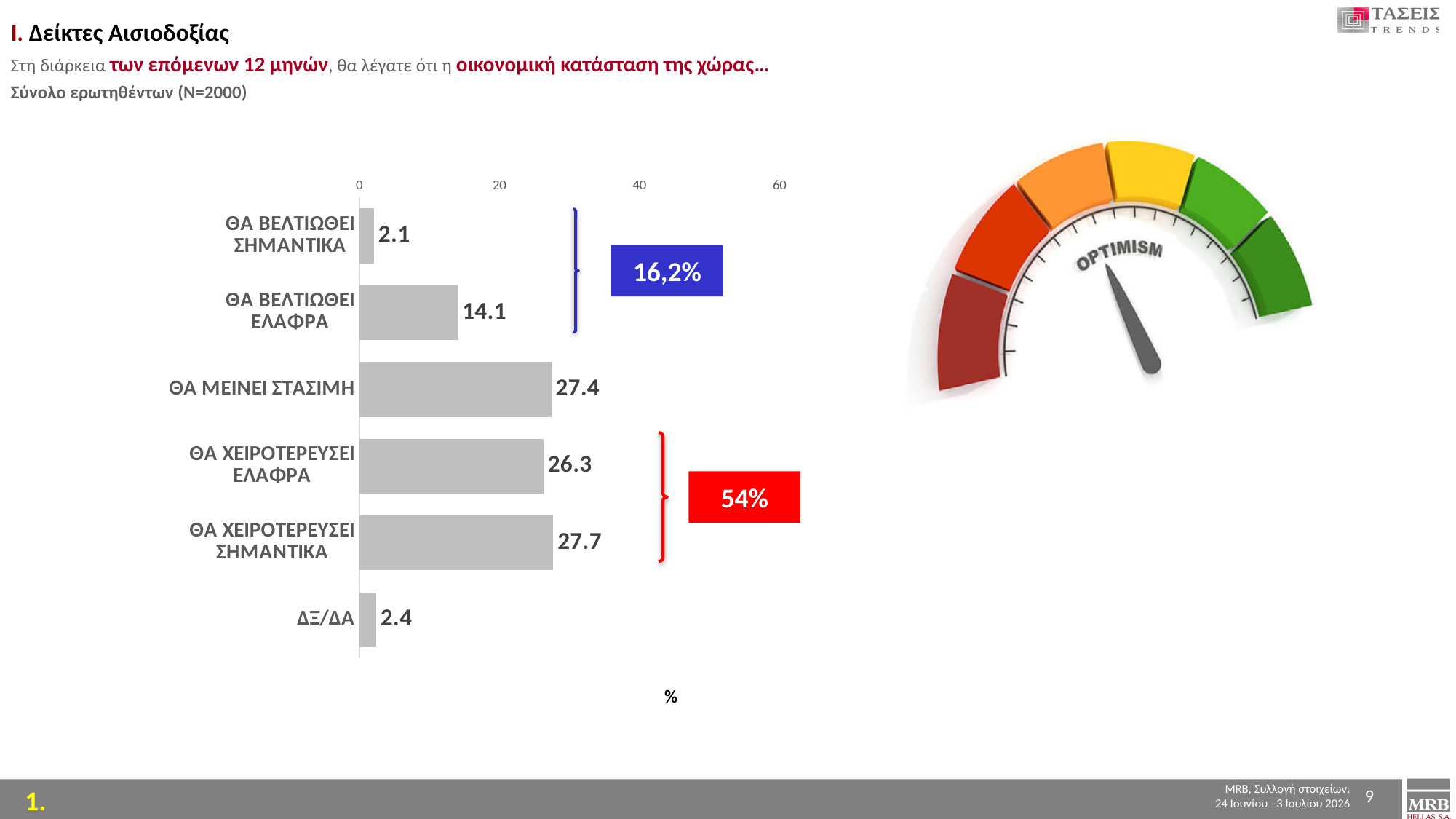
What is the value for ΘΑ ΒΕΛΤΙΩΘΕΙ ΕΛΑΦΡΑ? 14.1 Which is larger, the value for ΘΑ ΧΕΙΡΟΤΕΡΕΥΣΕΙ ΕΛΑΦΡΑ or the value for ΘΑ ΒΕΛΤΙΩΘΕΙ ΕΛΑΦΡΑ? ΘΑ ΧΕΙΡΟΤΕΡΕΥΣΕΙ ΕΛΑΦΡΑ What combined percentage is shown in the red box for the two ΘΑ ΧΕΙΡΟΤΕΡΕΥΣΕΙ categories? 54% How many categories are shown in the bar chart? 6 Is the value for ΘΑ ΧΕΙΡΟΤΕΡΕΥΣΕΙ ΕΛΑΦΡΑ greater or less than 20? greater What is the value for ΘΑ ΧΕΙΡΟΤΕΡΕΥΣΕΙ ΣΗΜΑΝΤΙΚΑ? 27.7 Which category has the highest value? ΘΑ ΧΕΙΡΟΤΕΡΕΥΣΕΙ ΣΗΜΑΝΤΙΚΑ What is the difference between the values for ΘΑ ΜΕΙΝΕΙ ΣΤΑΣΙΜΗ and ΘΑ ΒΕΛΤΙΩΘΕΙ ΕΛΑΦΡΑ? 13.3 What is the value for ΘΑ ΜΕΙΝΕΙ ΣΤΑΣΙΜΗ? 27.4 Which category has the lowest value? ΘΑ ΒΕΛΤΙΩΘΕΙ ΣΗΜΑΝΤΙΚΑ What kind of chart is used to show the responses? bar chart What is the value for ΔΞ/ΔΑ? 2.4